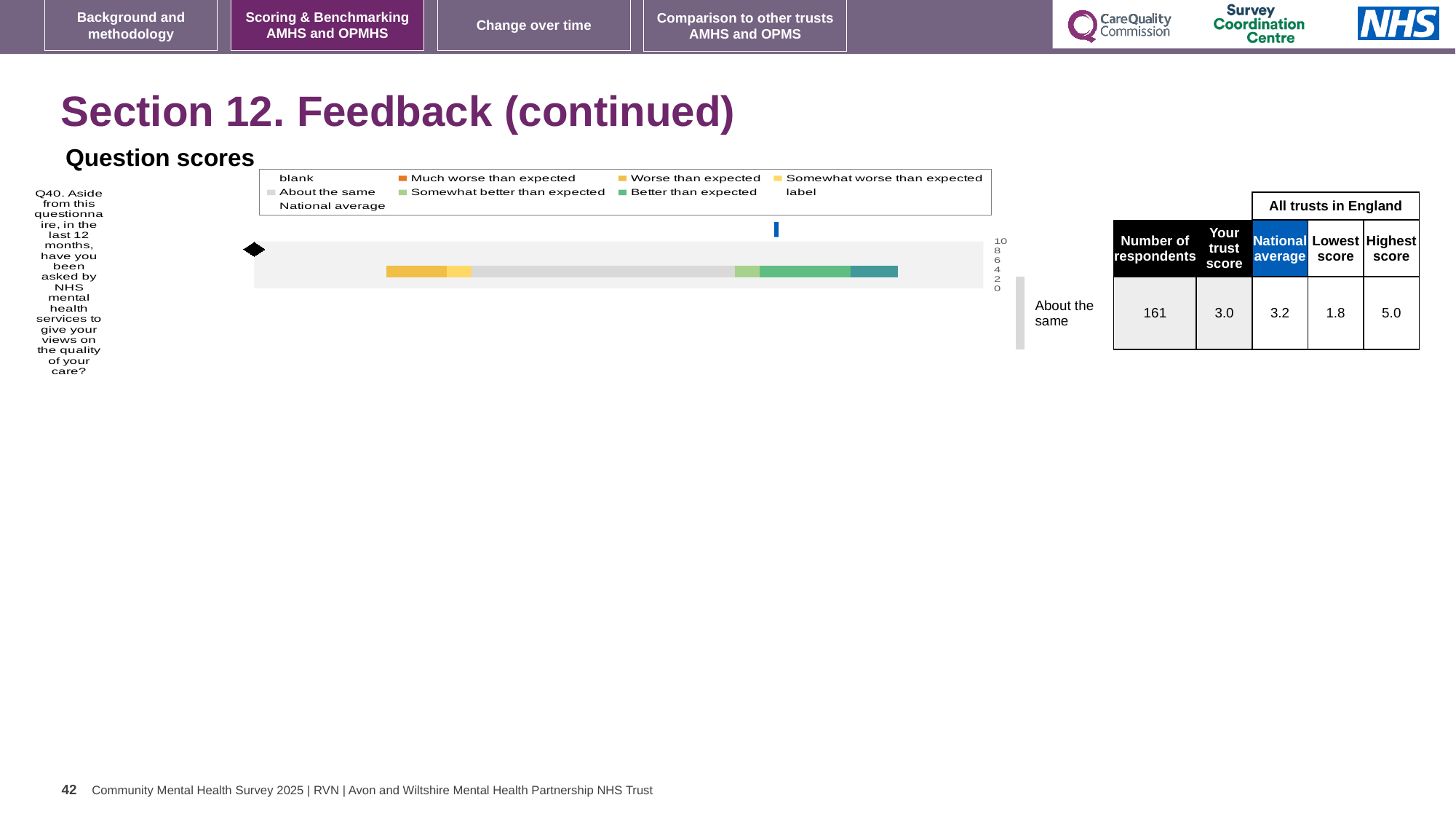
In the table beside the chart, what is the difference between the highest and lowest scores for Q40? 3.2 In the table beside the chart, what is the lowest score among all trusts in England for Q40? 1.8 What benchmark category is shown for Q40 next to the chart? About the same Which question is plotted in the Question scores chart? Q40 How many entries does the legend of the Question scores chart list? 9 How many questions (categories) are plotted in the Question scores chart? 1 In the table beside the chart, what is 'Your trust score' for Q40? 3.0 In the table beside the chart, what is the national average for Q40? 3.2 In the table beside the chart, which is larger for Q40: your trust score or the national average? National average In the table beside the chart, what is the highest score among all trusts in England for Q40? 5.0 What kind of chart is shown under 'Question scores'? bar chart In the table beside the chart, what is the number of respondents for Q40? 161